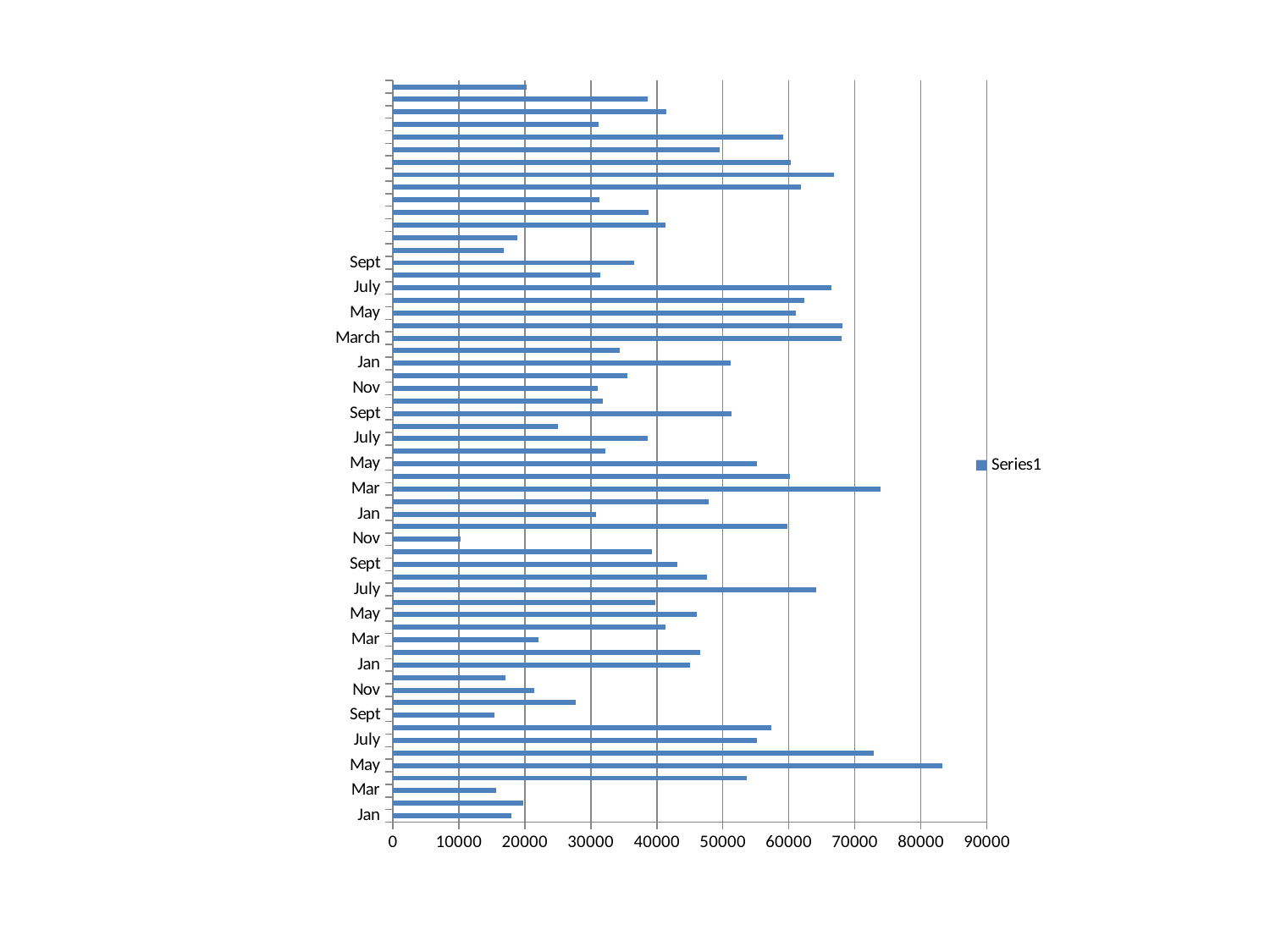
Is the value for the bar labelled March greater or less than 60000? greater Is the value of the bottom-most bar, labelled Jan, greater or less than 20000? less Which of the two bars is longer: the one labelled March or the bottom-most bar labelled Jan? March What is the highest value shown on the horizontal axis? 90000 Is the value of the longest bar in the chart greater or less than 80000? greater How many series does the legend list? 1 What is the name of the series shown in the legend? Series1 What kind of chart is shown on the slide? bar chart